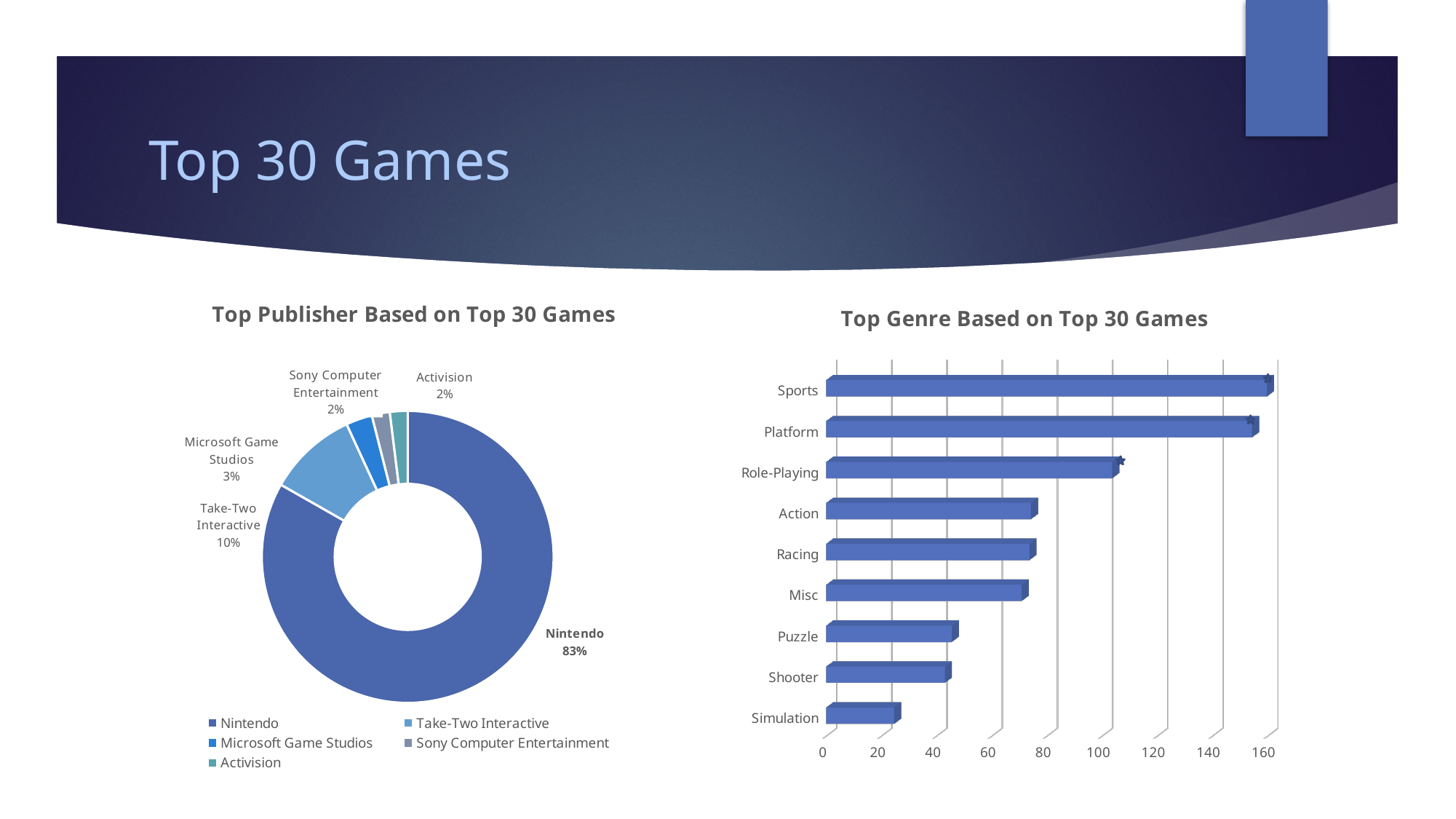
In the Top Genre Based on Top 30 Games chart, is the value for Action greater or less than 60? greater In the Top Genre Based on Top 30 Games chart, which genre has the lowest value? Simulation What kind of chart is the Top Genre Based on Top 30 Games chart? Bar chart In the Top Genre Based on Top 30 Games chart, which genre has the highest value? Sports In the Top Publisher Based on Top 30 Games chart, what share does Microsoft Game Studios have? 3% In the Top Publisher Based on Top 30 Games chart, which publisher has the largest share? Nintendo In the Top Publisher Based on Top 30 Games chart, what share does Nintendo have? 83% In the Top Publisher Based on Top 30 Games chart, what share does Take-Two Interactive have? 10% How many publishers are listed in the legend of the Top Publisher Based on Top 30 Games chart? 5 In the Top Genre Based on Top 30 Games chart, which has a higher value, Role-Playing or Action? Role-Playing In the Top Publisher Based on Top 30 Games chart, what is the difference between the shares of Nintendo and Take-Two Interactive? 73% In the Top Genre Based on Top 30 Games chart, is the value for Simulation greater or less than 40? less